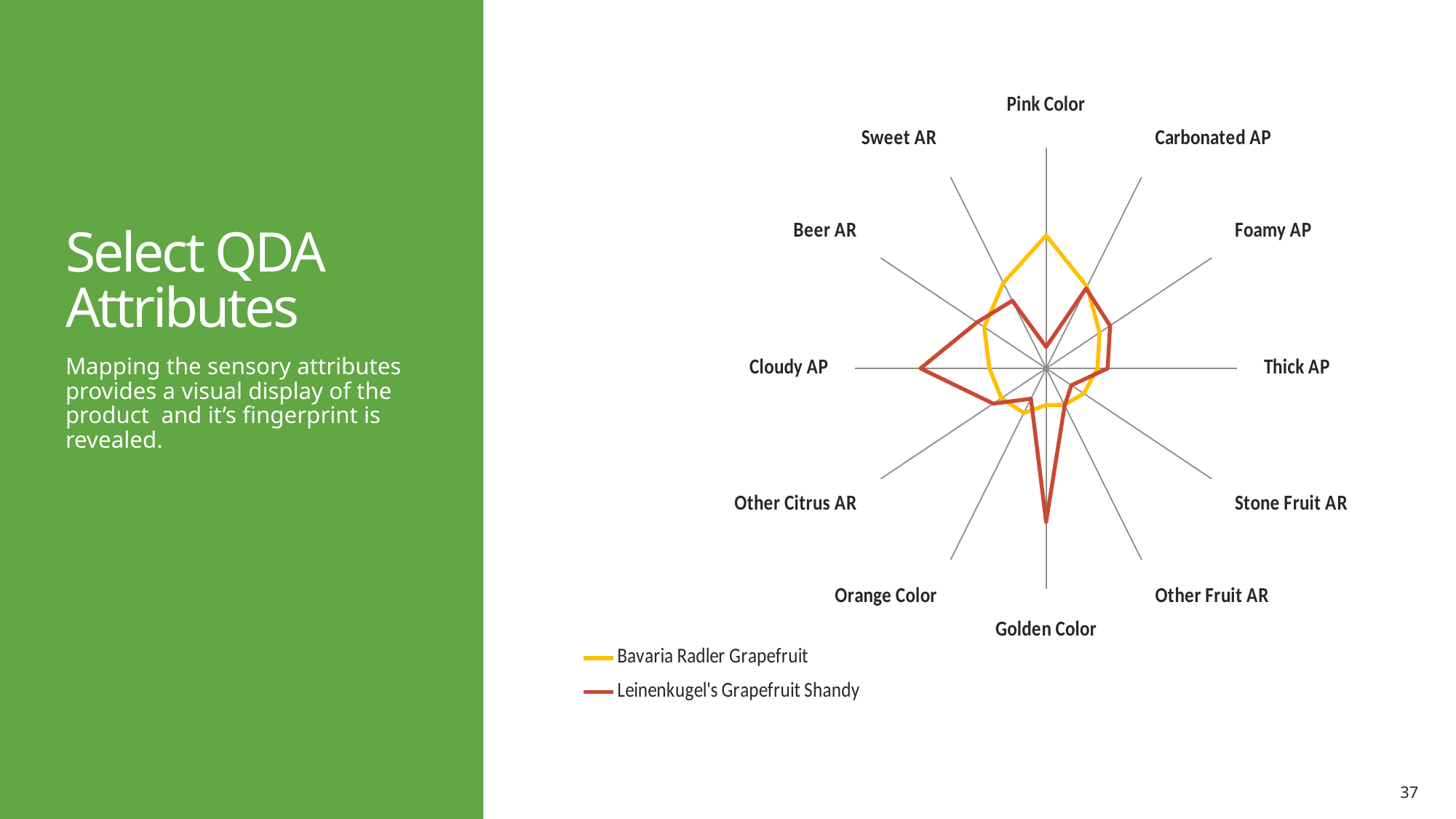
What kind of chart is shown on the slide? Radar chart On which attribute does Leinenkugel's Grapefruit Shandy score highest? Golden Color How many attributes (axes) does the radar chart have? 12 Which product scores higher on Beer AR? Leinenkugel's Grapefruit Shandy Which two products are compared in the chart? Bavaria Radler Grapefruit and Leinenkugel's Grapefruit Shandy On which attribute does Bavaria Radler Grapefruit score highest? Pink Color Which colour represents Leinenkugel's Grapefruit Shandy? Red Which product scores higher on Cloudy AP? Leinenkugel's Grapefruit Shandy Which product scores higher on Golden Color? Leinenkugel's Grapefruit Shandy How many series does the legend list? 2